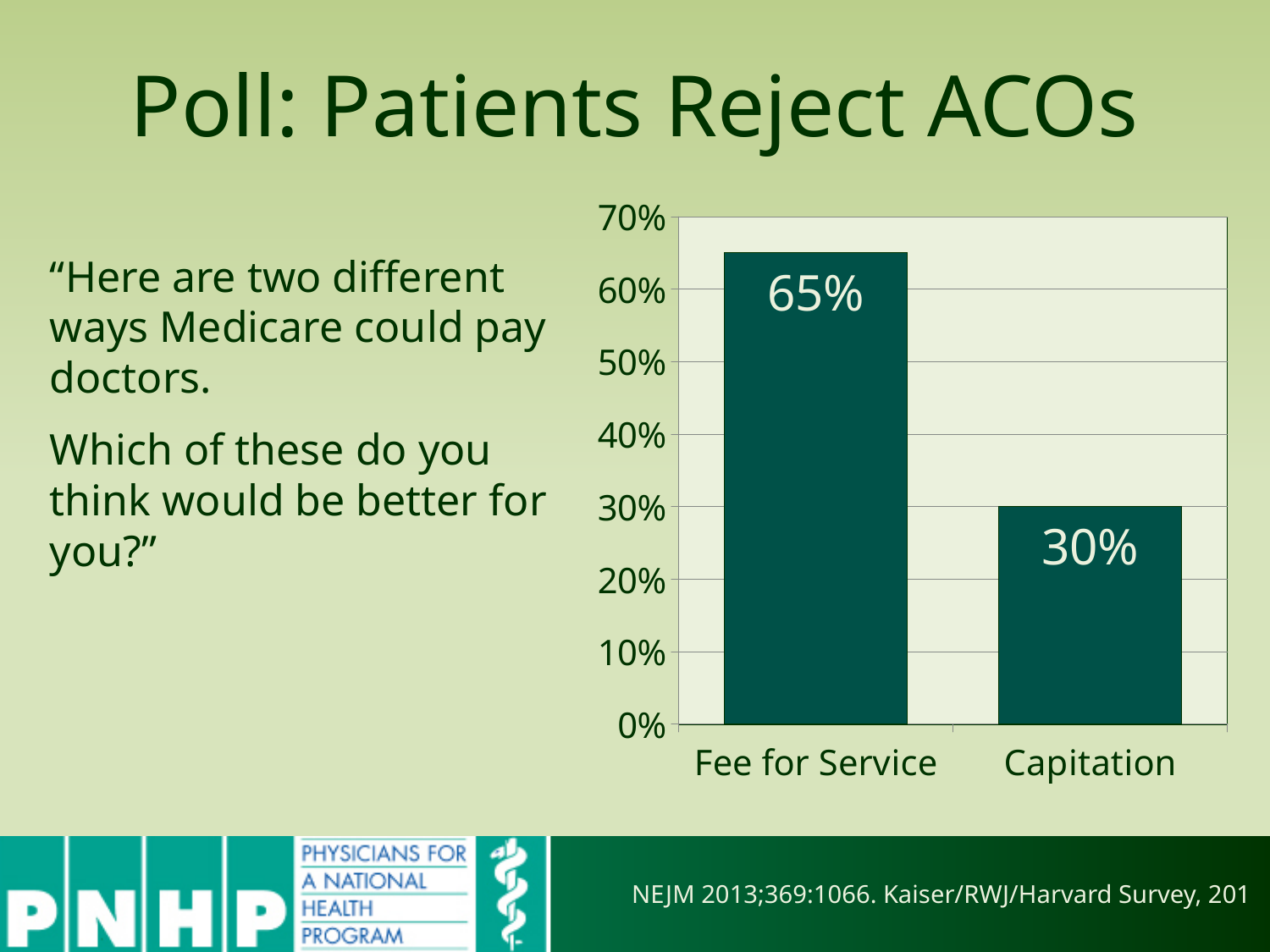
What is the title of the slide containing the chart? Poll: Patients Reject ACOs What is the difference between the values for Fee for Service and Capitation? 35% What kind of chart is shown on the slide? bar chart Is the value for Fee for Service greater or less than 60%? greater Is the value for Capitation greater or less than 40%? less Which category has the lowest value? Capitation What is the highest value shown on the vertical axis? 70% Which is larger, the value for Fee for Service or the value for Capitation? Fee for Service What is the value for Fee for Service? 65% What is the value for Capitation? 30% Which category has the highest value? Fee for Service How many categories are shown on the chart? 2